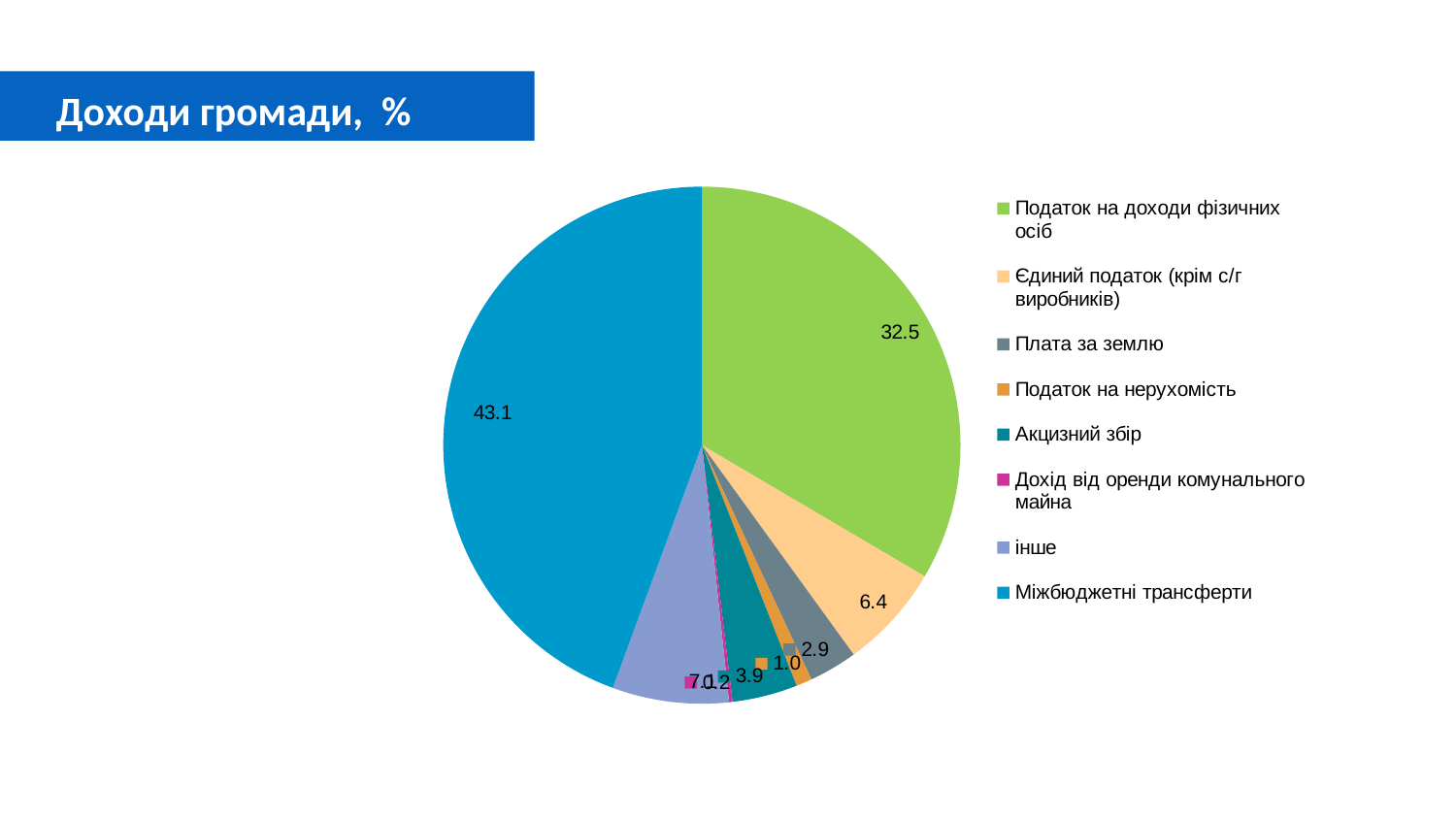
What is the value shown for Плата за землю? 2.9 What is the value shown for Податок на нерухомість? 1.0 What is the value shown for Акцизний збір? 3.9 What is the title of the chart on the slide? Доходи громади, % Which category has the smallest slice of the pie? Дохід від оренди комунального майна What is the value shown for Єдиний податок (крім с/г виробників)? 6.4 What is the value shown for Міжбюджетні трансферти? 43.1 Which category has the largest slice of the pie? Міжбюджетні трансферти What kind of chart is shown on the slide? pie chart What is the value shown for Податок на доходи фізичних осіб? 32.5 How many categories does the legend of the pie chart list? 8 What is the difference between the values for Міжбюджетні трансферти and Податок на доходи фізичних осіб? 10.6